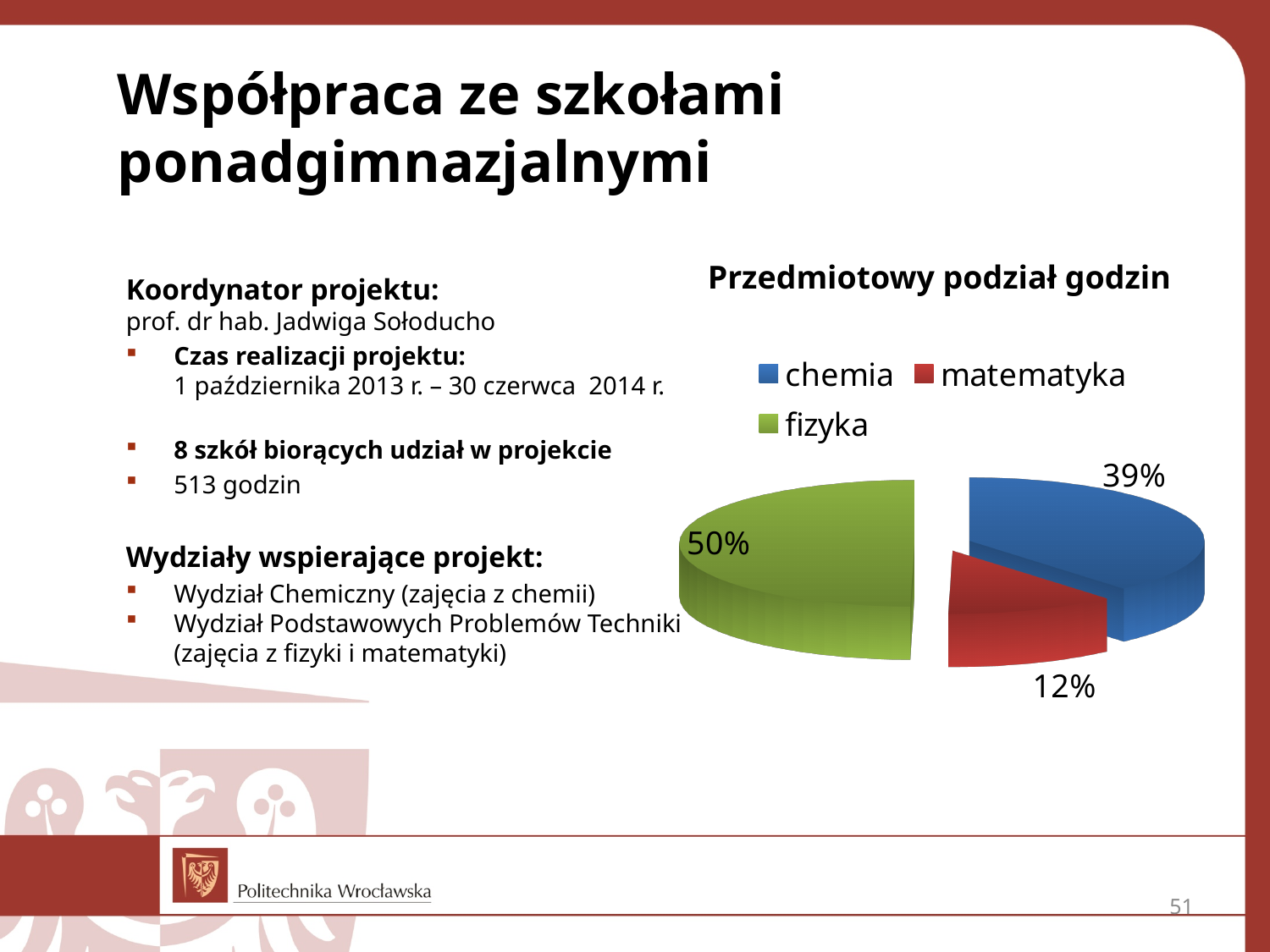
Which subject has the largest slice of the pie? fizyka How many entries does the legend list? 3 What type of chart is shown on the slide? pie chart What is the title of the chart? Przedmiotowy podział godzin What share of the pie does fizyka have? 50% What share of the pie does chemia have? 39% Which slice is larger, chemia or matematyka? chemia What colour is the slice for matematyka? red How many slices does the pie chart have? 3 Which subject has the smallest slice of the pie? matematyka What is the difference in percentage points between the fizyka and chemia slices? 11% What share of the pie does matematyka have? 12%